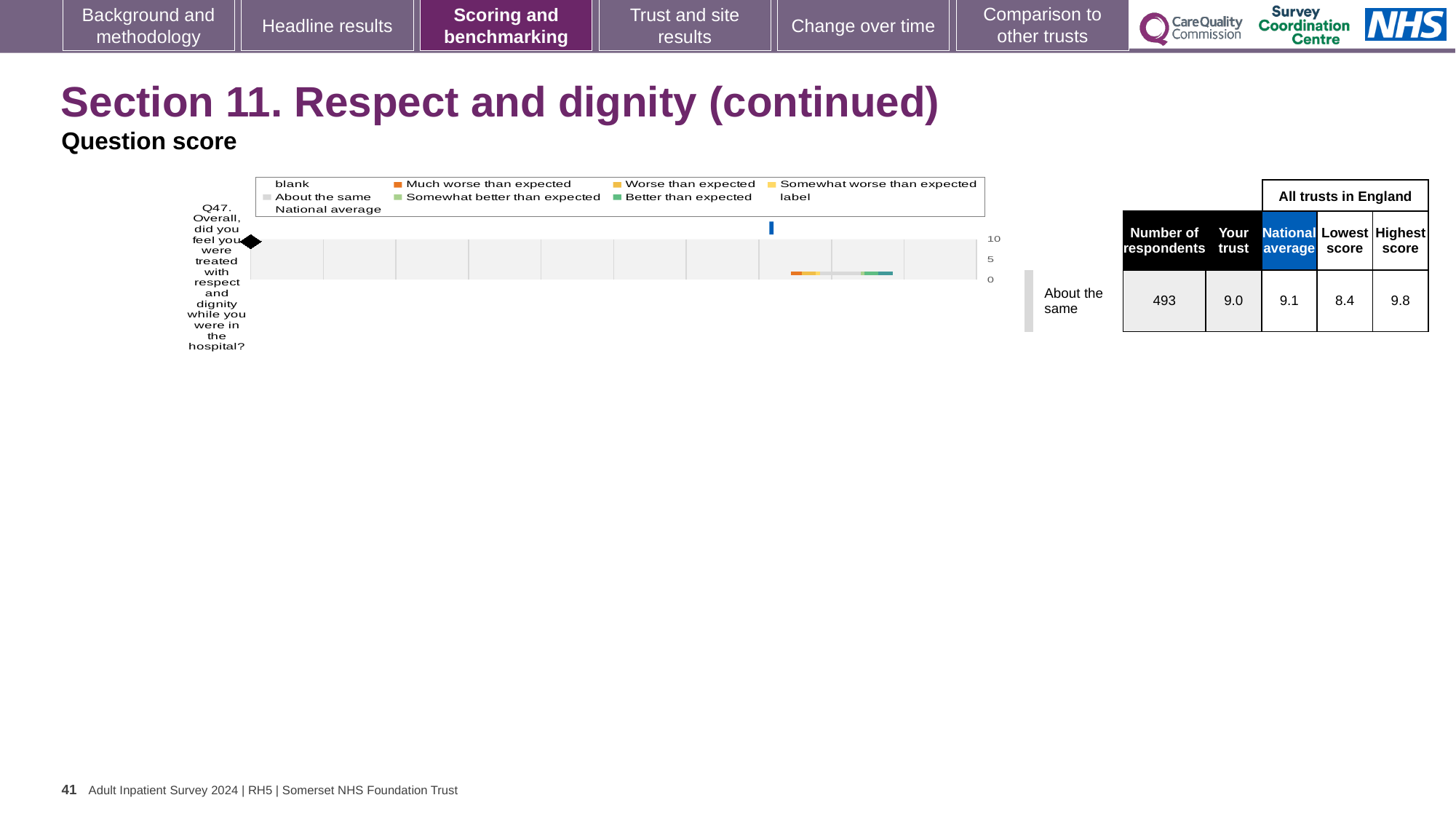
What kind of chart is shown on the slide? bar chart What is the 'Your trust' score for Q47? 9.0 How many questions (categories) are plotted in the chart? 1 Which question is plotted in the chart? Q47. Overall, did you feel you were treated with respect and dignity while you were in the hospital? What is the highest tick value shown on the chart's axis? 10 What benchmark category is the trust's Q47 score placed in? About the same What is the Lowest score among all trusts in England for Q47? 8.4 What is the Highest score among all trusts in England for Q47? 9.8 What is the difference between the Highest score and the Lowest score for Q47? 1.4 How many respondents answered Q47? 493 Which is larger for Q47, the 'Your trust' score or the National average? National average What is the National average score for Q47? 9.1